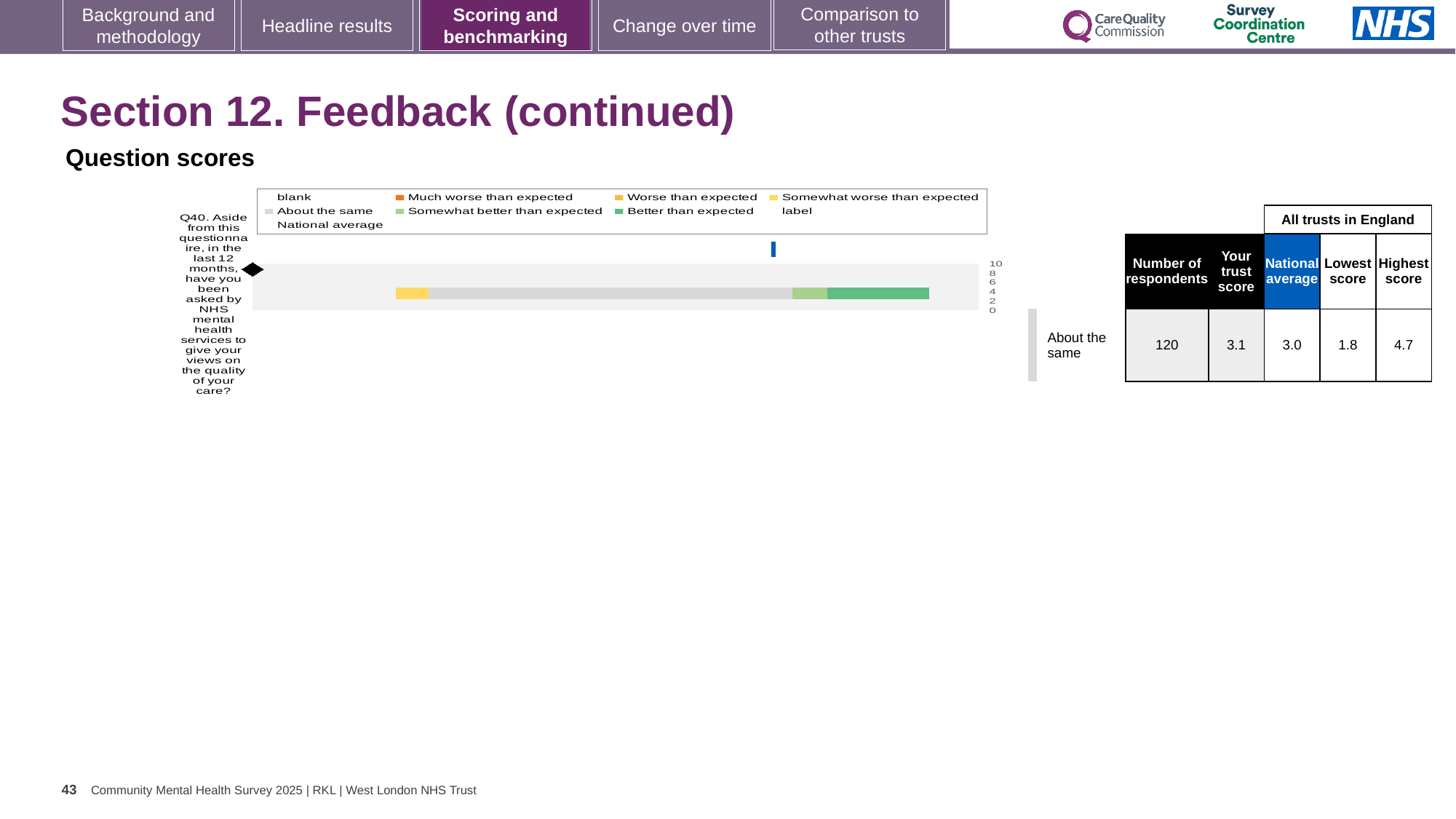
How many survey questions are plotted on the chart? 1 What is the difference between the highest score and the lowest score for Q40 across all trusts in England? 2.9 Which benchmark category does the trust's score for Q40 fall into? About the same Which is larger for Q40, the trust's score or the national average? the trust's score Which question is plotted on the chart? Q40. Aside from this questionnaire, in the last 12 months, have you been asked by NHS mental health services to give your views on the quality of your care? What kind of chart is used to show the Q40 question score? bar chart What colour does the legend use for the 'Better than expected' band? green What is the trust's score for Q40? 3.1 What is the lowest score for Q40 among all trusts in England? 1.8 What is the national average score for Q40? 3.0 How many respondents answered Q40? 120